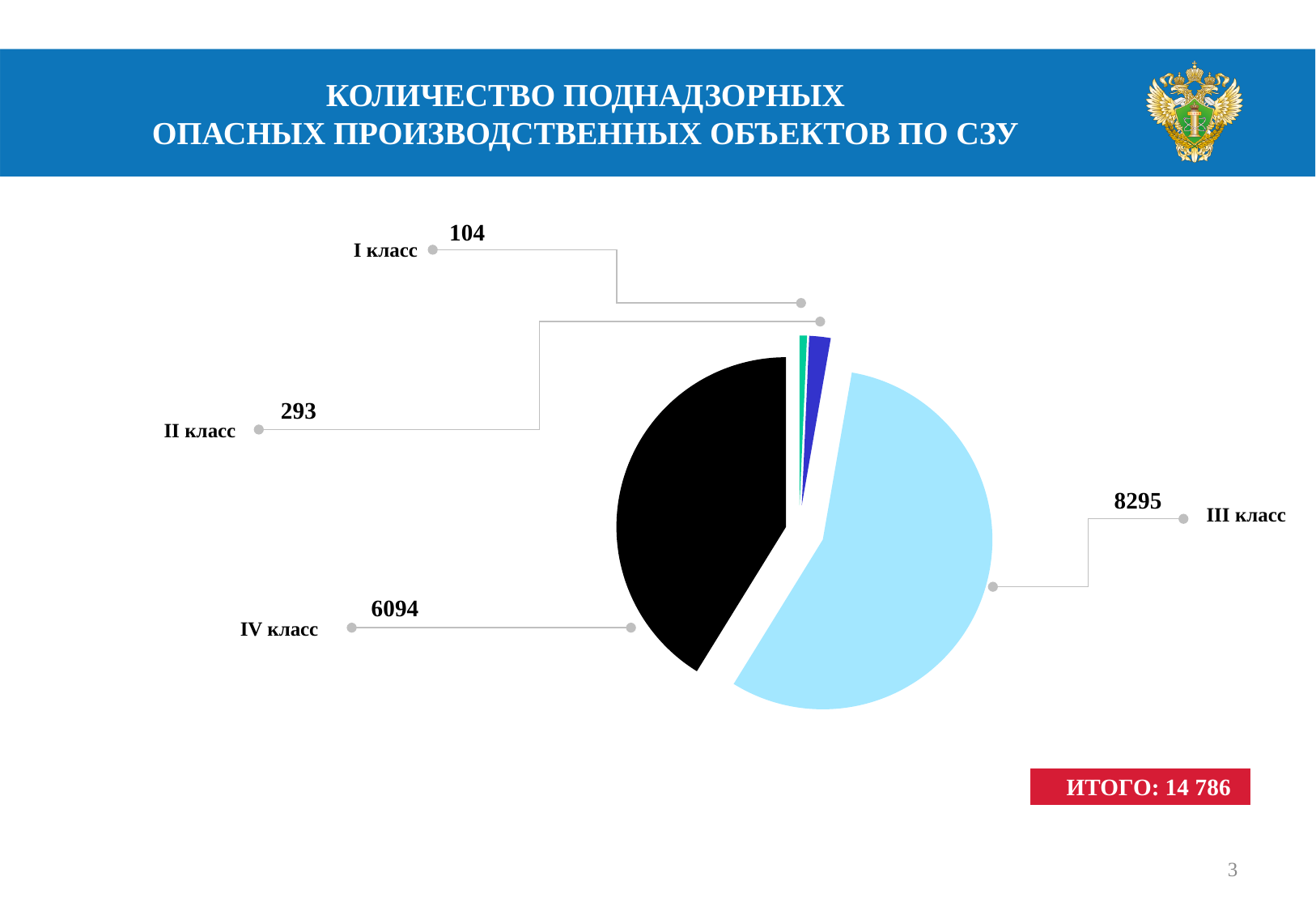
What is the value for I класс? 104 What is the value for III класс? 8295 What is the difference between the values for III класс and IV класс? 2201 What is the difference between the values for II класс and I класс? 189 Which class has the largest slice of the pie? III класс What is the value for II класс? 293 What type of chart is shown on the slide? pie chart What is the value for IV класс? 6094 Which is larger, the value for II класс or the value for I класс? II класс How many categories (classes) are shown in the pie chart? 4 What total (ИТОГО) is shown on the slide? 14 786 Which class has the smallest slice of the pie? I класс